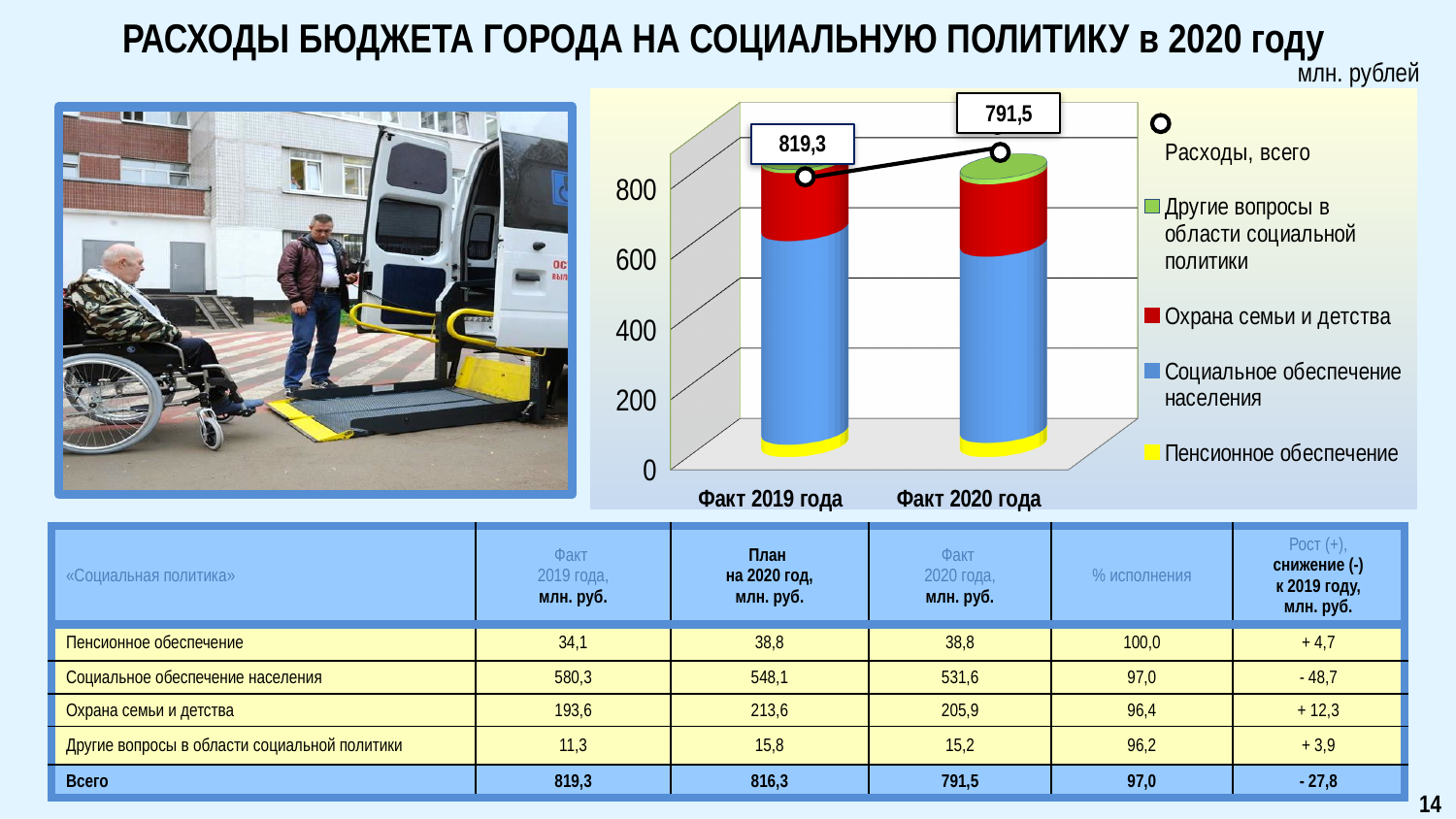
By how much did total expenditure ('Расходы, всего') fall from Факт 2019 года to Факт 2020 года? 27,8 What is the value of the 'Расходы, всего' data label for Факт 2019 года? 819,3 Is the total for Факт 2020 года greater or less than 800? less What kind of chart is shown on the slide? stacked bar chart Is the total for Факт 2019 года greater or less than 800? greater How many categories are shown on the x axis of the chart? 2 Which legend entry is shown in red? Охрана семьи и детства Which legend entry is shown in yellow? Пенсионное обеспечение How many entries does the chart legend list? 5 What is the value of the 'Расходы, всего' data label for Факт 2020 года? 791,5 Which category has the higher total expenditure, Факт 2019 года or Факт 2020 года? Факт 2019 года Does the 'Расходы, всего' line rise or fall from Факт 2019 года to Факт 2020 года? fall